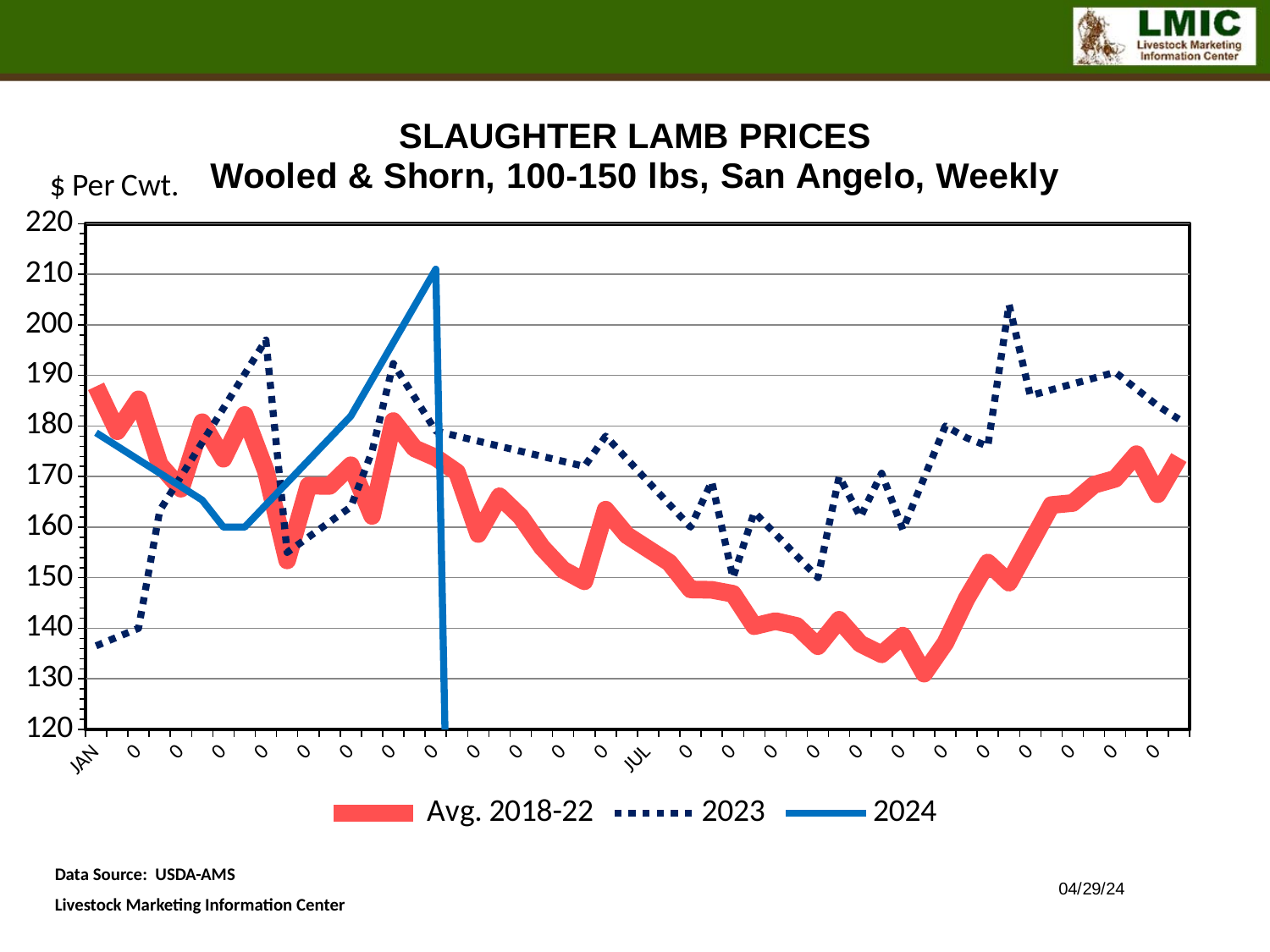
How many series does the legend list? 3 At JAN, which is higher: the Avg. 2018-22 line or the 2023 line? Avg. 2018-22 What kind of chart is shown on the slide? line chart Is the value of the 2023 line at JAN greater or less than 140? less Does the Avg. 2018-22 line generally rise or fall from JAN to JUL? fall What is the title of the chart? SLAUGHTER LAMB PRICES, Wooled & Shorn, 100-150 lbs, San Angelo, Weekly Is the lowest value of the Avg. 2018-22 line greater or less than 140? less Which series reaches the highest value on the chart? 2024 Is the value of the Avg. 2018-22 line at JAN greater or less than 180? greater What unit is shown on the y axis of the chart? $ Per Cwt.